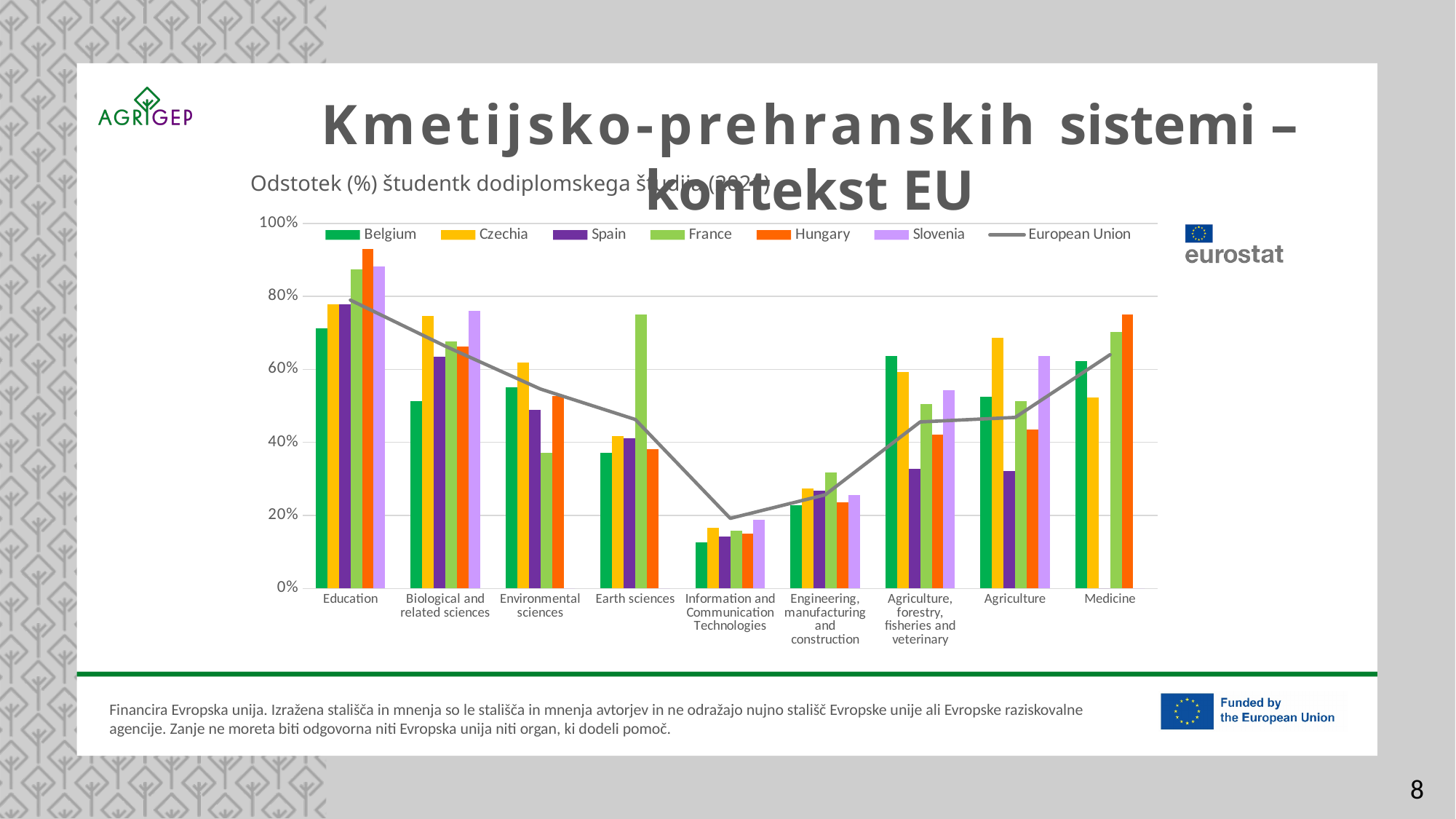
In which field is the European Union line at its lowest? Information and Communication Technologies In Agriculture, which is larger: the value for Belgium or for Czechia? Czechia Is the value for Spain in Agriculture greater or less than 40%? less Is the value for Hungary in Education greater or less than 80%? greater Is the value for France in Earth sciences greater or less than 60%? greater Which country has the highest bar in Earth sciences? France How many fields of study (categories) are shown on the x axis? 9 How many series does the chart legend list? 7 What colour are the bars for Hungary? Orange What kind of chart is shown on the slide? Bar chart with a line for the European Union Which series is drawn as a line rather than bars? European Union